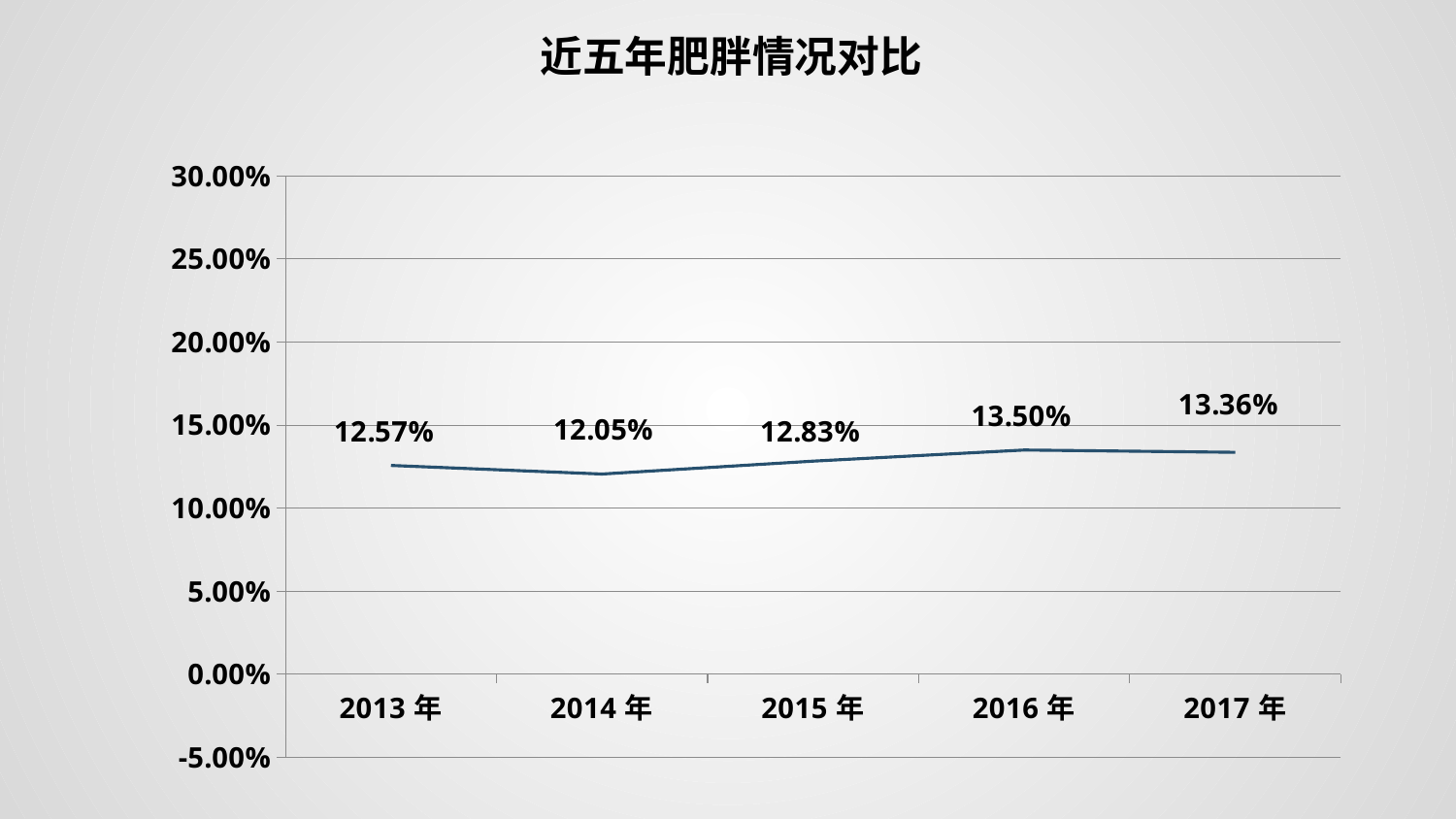
Which is larger, the value for 2013 年 or the value for 2015 年? 2015 年 What is the difference between the values for 2016 年 and 2014 年? 1.45% How many years are plotted on the chart? 5 What is the value for 2017 年? 13.36% What is the value for 2013 年? 12.57% Which year has the lowest value? 2014 年 Is the value for 2016 年 greater or less than 15.00%? less Which year has the highest value? 2016 年 What kind of chart is this? line chart What is the difference between the values for 2015 年 and 2013 年? 0.26% What is the title of the chart? 近五年肥胖情况对比 What is the value for 2016 年? 13.50%